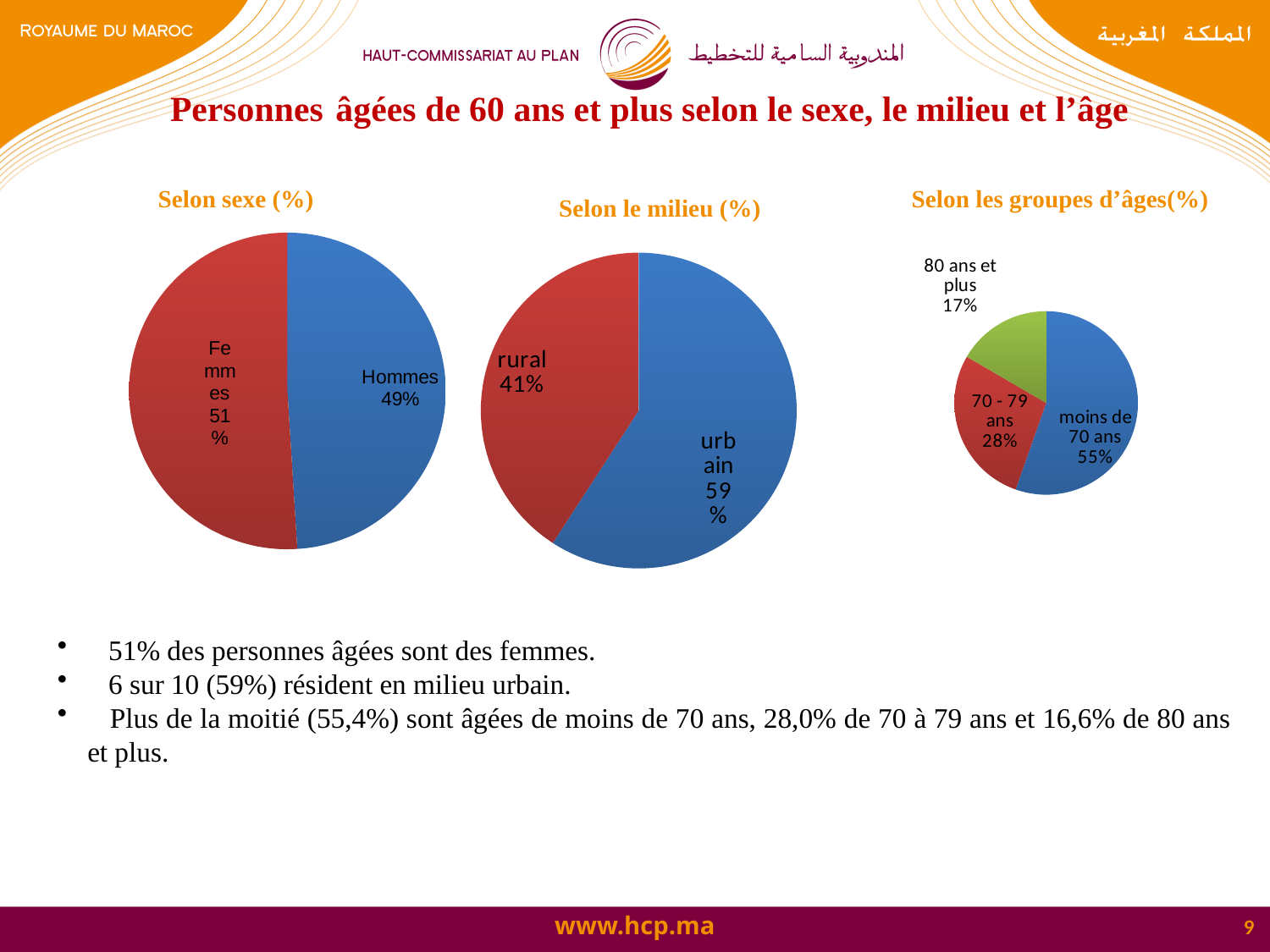
What kind of chart is the 'Selon le milieu (%)' chart? Pie chart How many charts are shown on the slide? 3 In the 'Selon le milieu (%)' chart, what is the difference between urbain and rural? 18% How many categories does the 'Selon les groupes d'âges(%)' chart show? 3 In the 'Selon les groupes d'âges(%)' chart, which is larger: 70 - 79 ans or 80 ans et plus? 70 - 79 ans In the 'Selon les groupes d'âges(%)' chart, what is the value for 70 - 79 ans? 28% In the 'Selon sexe (%)' chart, what is the value for Femmes? 51% In the 'Selon le milieu (%)' chart, what is the value for rural? 41% In the 'Selon sexe (%)' chart, what is the value for Hommes? 49% In the 'Selon le milieu (%)' chart, what is the value for urbain? 59% In the 'Selon les groupes d'âges(%)' chart, which category has the largest share? moins de 70 ans In the 'Selon les groupes d'âges(%)' chart, which category has the smallest share? 80 ans et plus